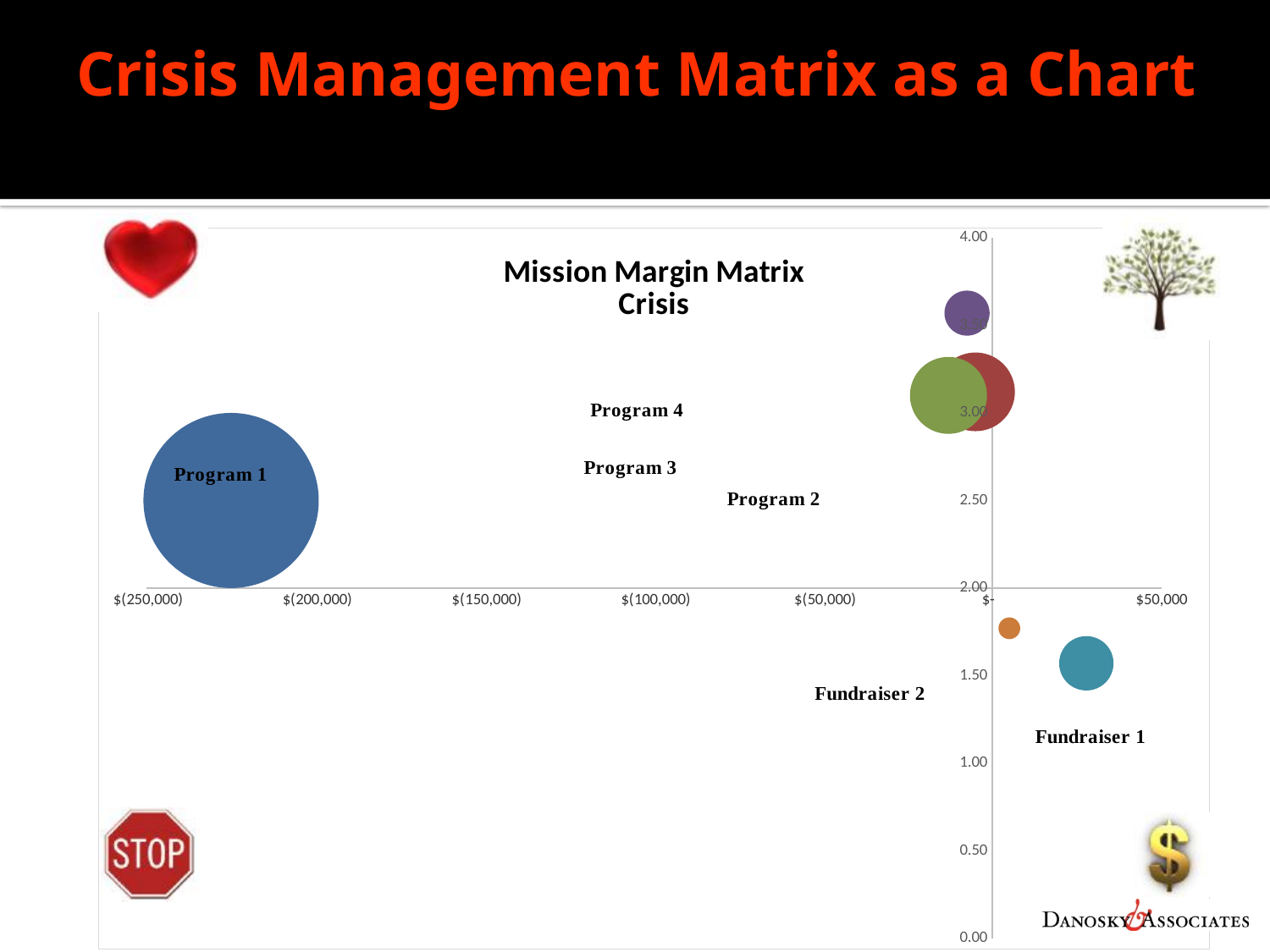
Is the horizontal-axis value for Fundraiser 1 greater or less than $-? greater Which labeled item is plotted furthest to the right on the horizontal axis? Fundraiser 1 Is the vertical-axis value for Fundraiser 1 greater or less than 2.00? less What kind of chart is shown on the slide? Bubble chart Is the vertical-axis value for Program 1 greater or less than 2.00? greater How many labeled programs and fundraisers are shown on the chart? 6 What is the highest value shown on the vertical axis? 4.00 Which labeled item is plotted furthest to the left on the horizontal axis? Program 1 Which has a higher vertical-axis value, Program 1 or Fundraiser 1? Program 1 What is the leftmost value shown on the horizontal axis? $(250,000) What is the title of the chart? Mission Margin Matrix Crisis Which labeled item has the largest bubble on the chart? Program 1